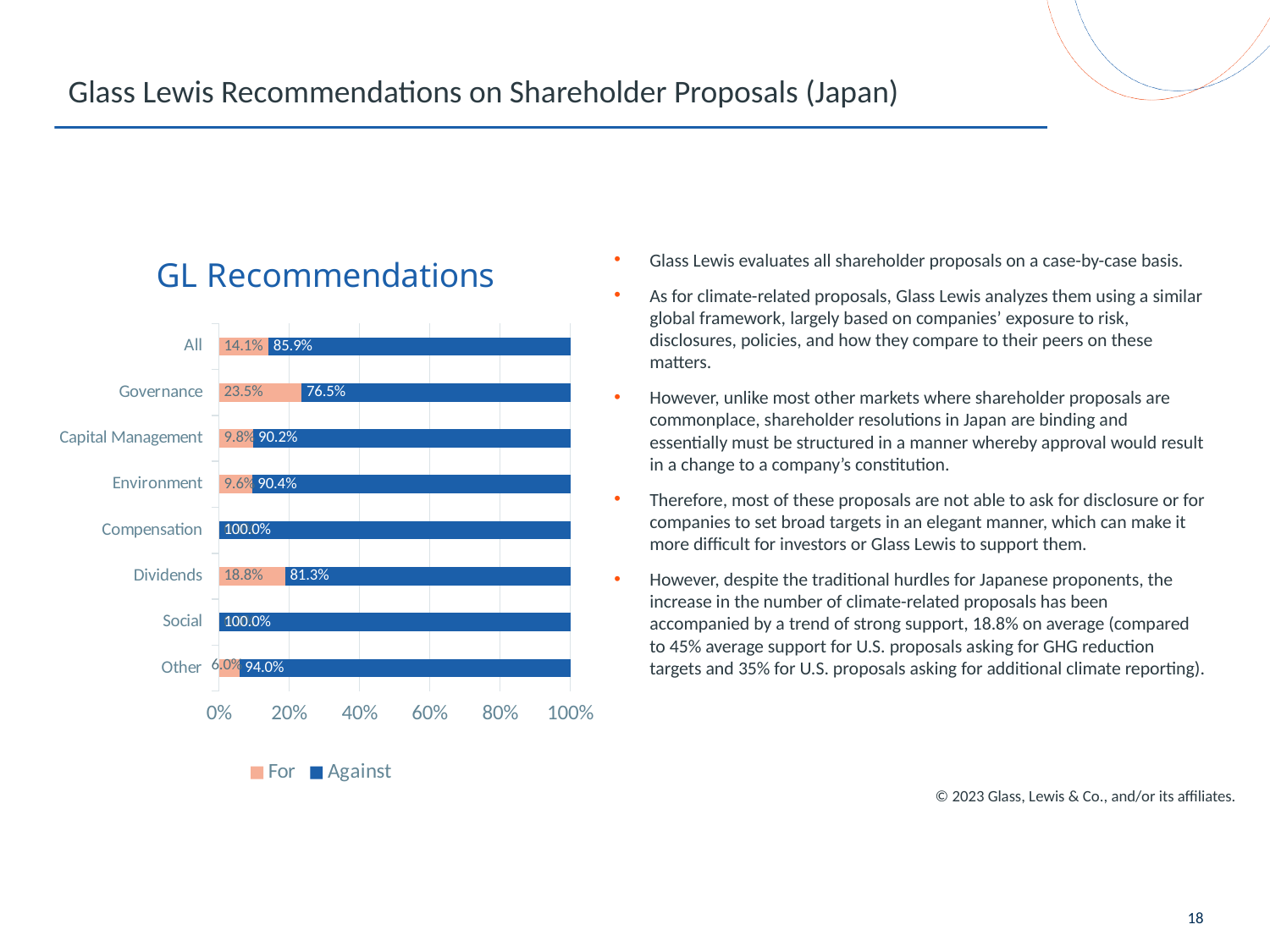
What is the 'Against' value for Dividends? 81.3% How many categories are shown on the chart? 8 What is the 'For' value for Other? 6.0% What is the 'For' value for Governance? 23.5% What is the title of the chart? GL Recommendations How many series does the legend list? 2 What is the 'Against' value for All? 85.9% What kind of chart is shown? Stacked bar chart Which is larger, the 'For' value for Capital Management or the 'For' value for Environment? Capital Management Which category has the highest 'For' value? Governance Which category has the lowest 'Against' value? Governance What is the difference between the 'For' values for Governance and Dividends? 4.7%